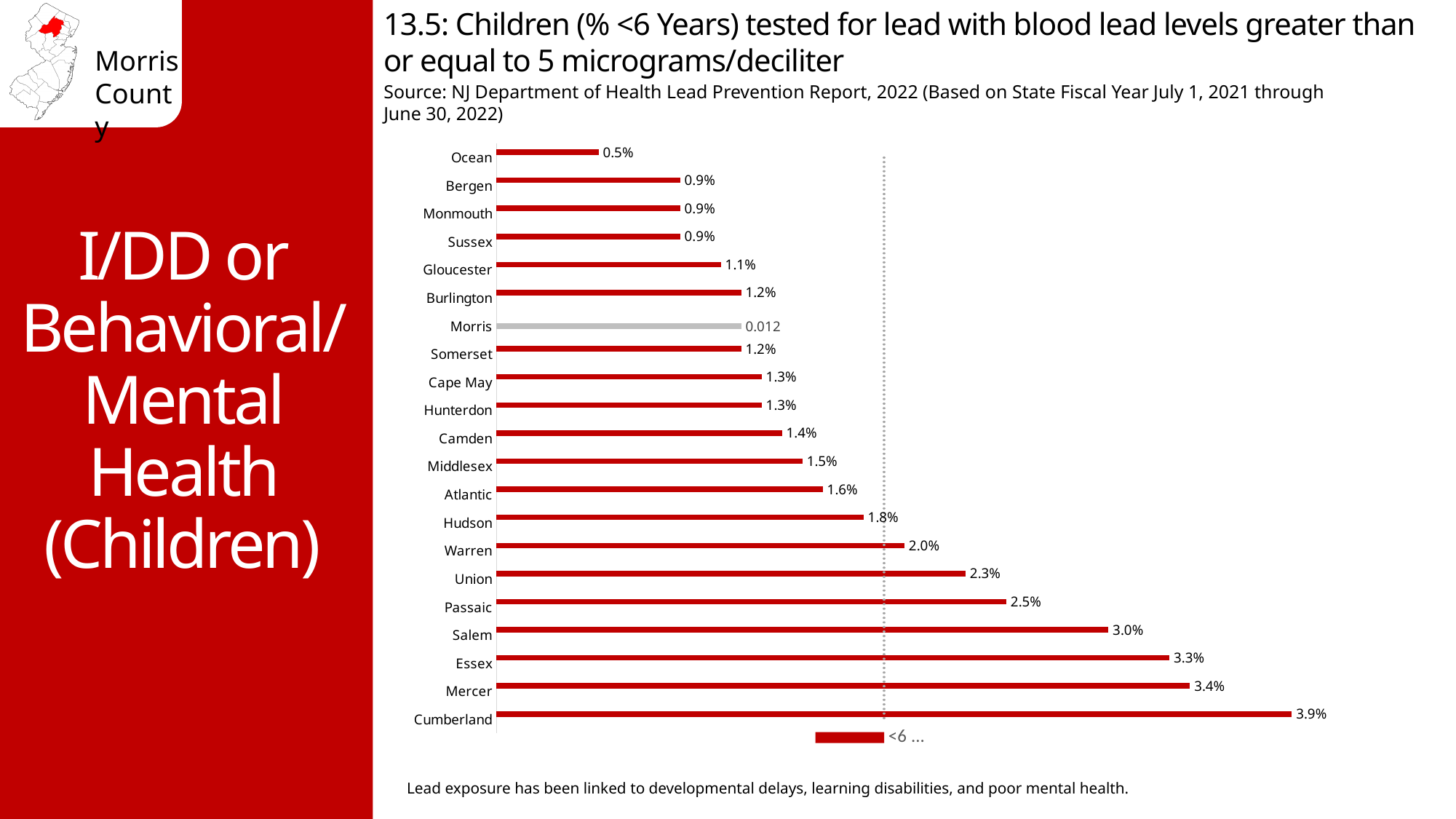
What is the value for Salem? 3.0% Which has a larger value, Essex or Mercer? Mercer Which county's bar is coloured grey instead of red? Morris What kind of chart is shown on the slide? Bar chart What is the difference between the values for Cumberland and Ocean? 3.4% What is the data label shown for Morris? 0.012 What is the value for Ocean? 0.5% What is the value for Cumberland? 3.9% How many counties are shown in the chart? 21 Which county has the highest value? Cumberland Which county has the lowest value? Ocean What is the difference between the values for Passaic and Union? 0.2%